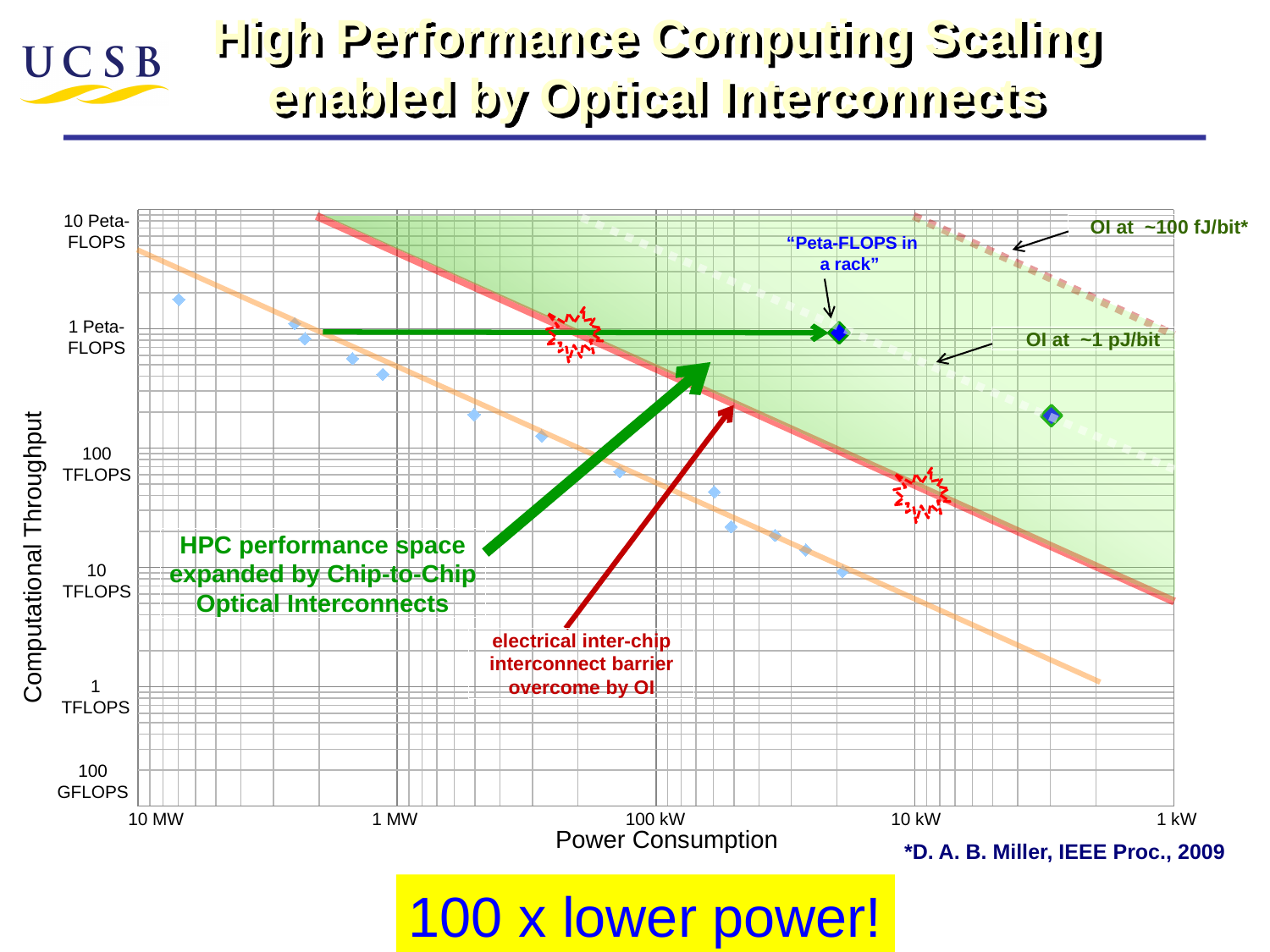
Do the light blue data points rise or fall from left to right along the x axis? fall Is the computational throughput of the rightmost diamond marker greater or less than 100 TFLOPS? greater How many labeled tick marks are on the x axis? 5 How many labeled tick marks are on the y axis? 6 What is the label of the x axis? Power Consumption Is the computational throughput of the rightmost diamond marker greater or less than 1 Peta-FLOPS? less What computational throughput does the point labeled "Peta-FLOPS in a rack" sit on? 1 Peta-FLOPS What is the leftmost tick label on the x axis? 10 MW What is the lowest tick label on the y axis? 100 GFLOPS What kind of chart is shown on the slide? scatter chart Is the power consumption of the point labeled "Peta-FLOPS in a rack" greater or less than 100 kW? less What is the label of the y axis? Computational Throughput